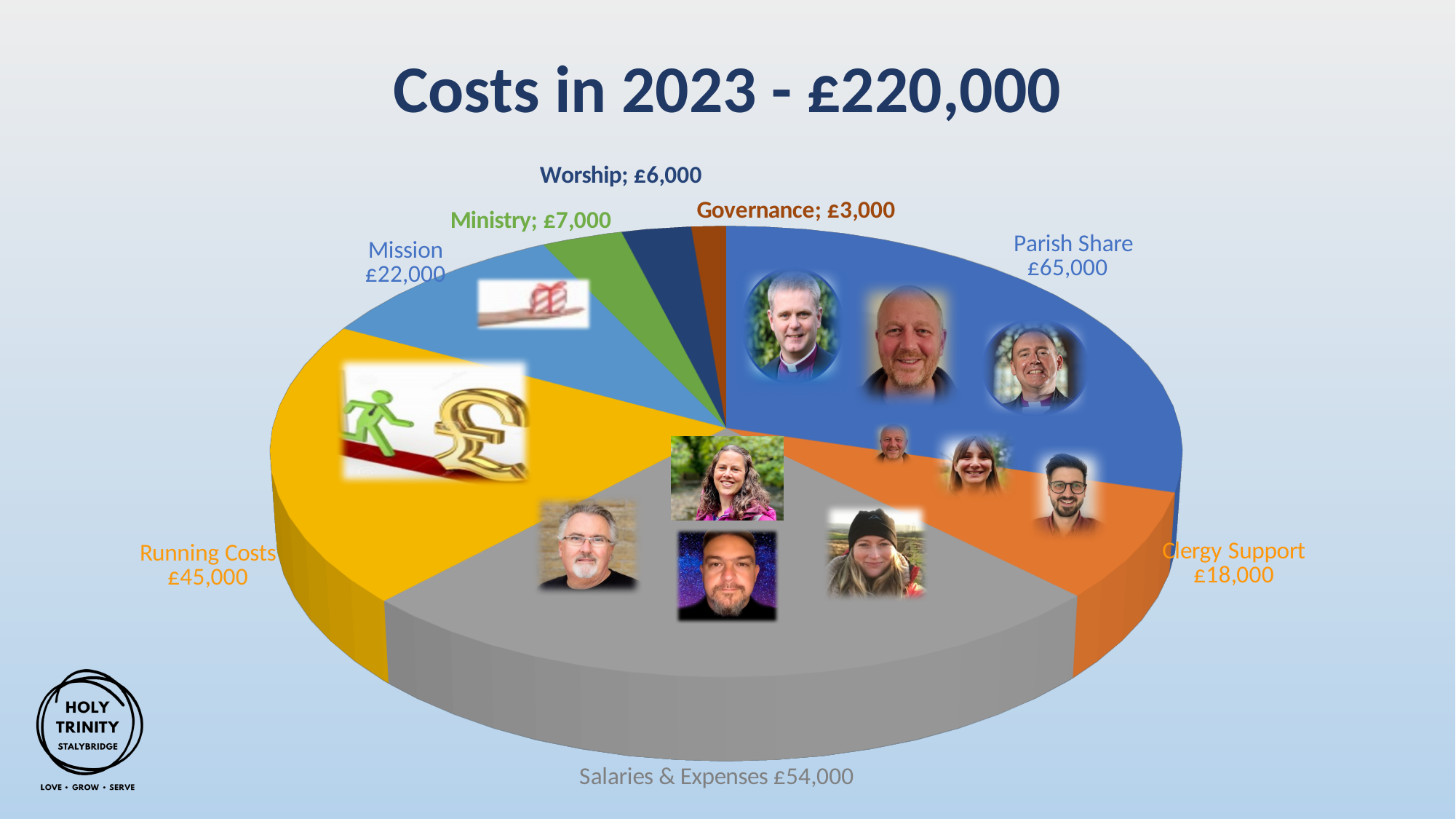
Which category has the highest cost? Parish Share What is the value for Governance? £3,000 What share of the total costs does Mission represent? 10% How many categories are shown in the pie chart? 8 Which is larger, Mission or Clergy Support? Mission What is the title of the chart? Costs in 2023 - £220,000 What is the difference between Running Costs and Clergy Support? £27,000 What is the total of all costs shown in the chart title? £220,000 What is the value for Salaries & Expenses? £54,000 What is the value for Parish Share? £65,000 Which category has the lowest cost? Governance What kind of chart is shown on the slide? Pie chart